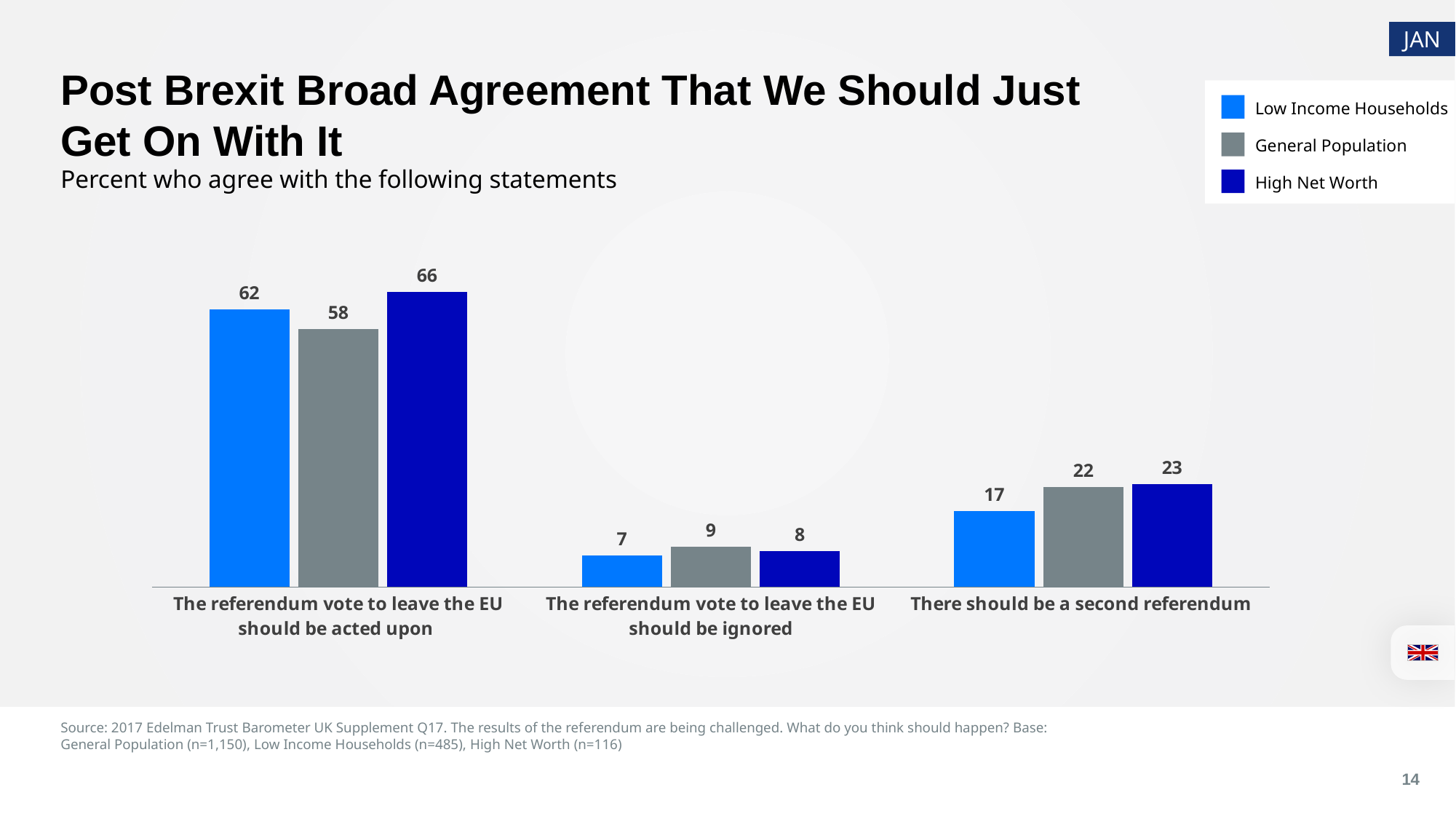
For 'The referendum vote to leave the EU should be ignored', which is larger: the General Population value or the Low Income Households value? General Population What is the difference between the High Net Worth and General Population values for 'The referendum vote to leave the EU should be acted upon'? 8 How many statements (categories) are shown on the x axis? 3 What percent of Low Income Households agree that the referendum vote to leave the EU should be acted upon? 62 What percent of High Net Worth respondents agree that the referendum vote to leave the EU should be ignored? 8 What is the difference between the General Population and Low Income Households values for 'There should be a second referendum'? 5 How many series does the legend list? 3 Which group has the lowest value for 'There should be a second referendum'? Low Income Households What percent of the General Population agree that there should be a second referendum? 22 Which colour represents the General Population series in the legend? Grey Which group has the highest value for 'The referendum vote to leave the EU should be acted upon'? High Net Worth What kind of chart is shown on the slide? Bar chart